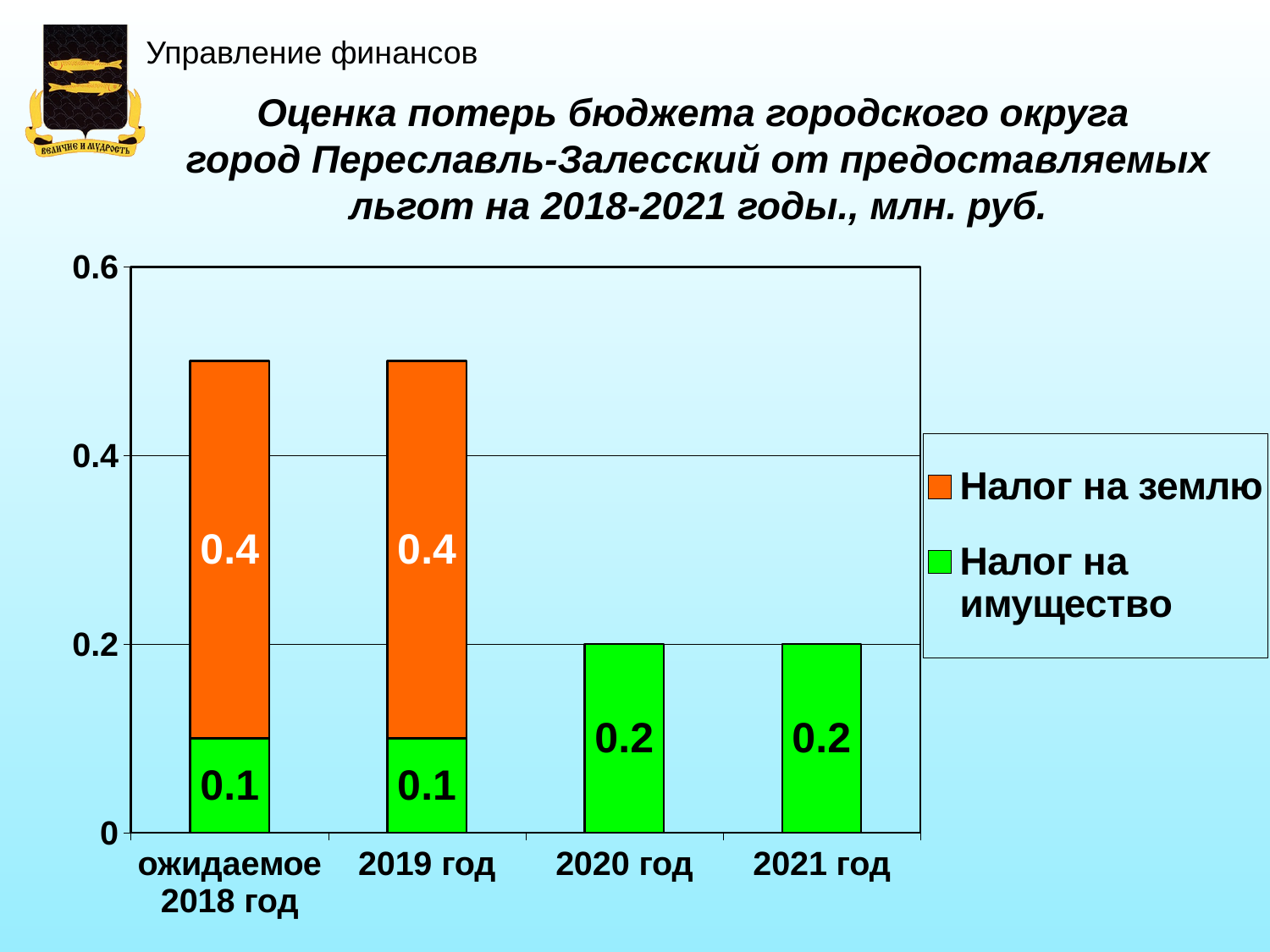
What is the total of the stacked bar for ожидаемое 2018 год? 0.5 How many categories are shown on the x axis? 4 What is the difference between Налог на землю and Налог на имущество in 2019 год? 0.3 What is the value for Налог на имущество in 2020 год? 0.2 What is the value for Налог на имущество in 2021 год? 0.2 What kind of chart is shown on the slide? Stacked bar chart What is the total of the stacked bar for 2019 год? 0.5 What is the value for Налог на имущество in ожидаемое 2018 год? 0.1 How many series does the legend list? 2 What is the value for Налог на землю in 2019 год? 0.4 Which is larger in ожидаемое 2018 год: Налог на землю or Налог на имущество? Налог на землю Which category has the lowest value for Налог на имущество? ожидаемое 2018 год and 2019 год